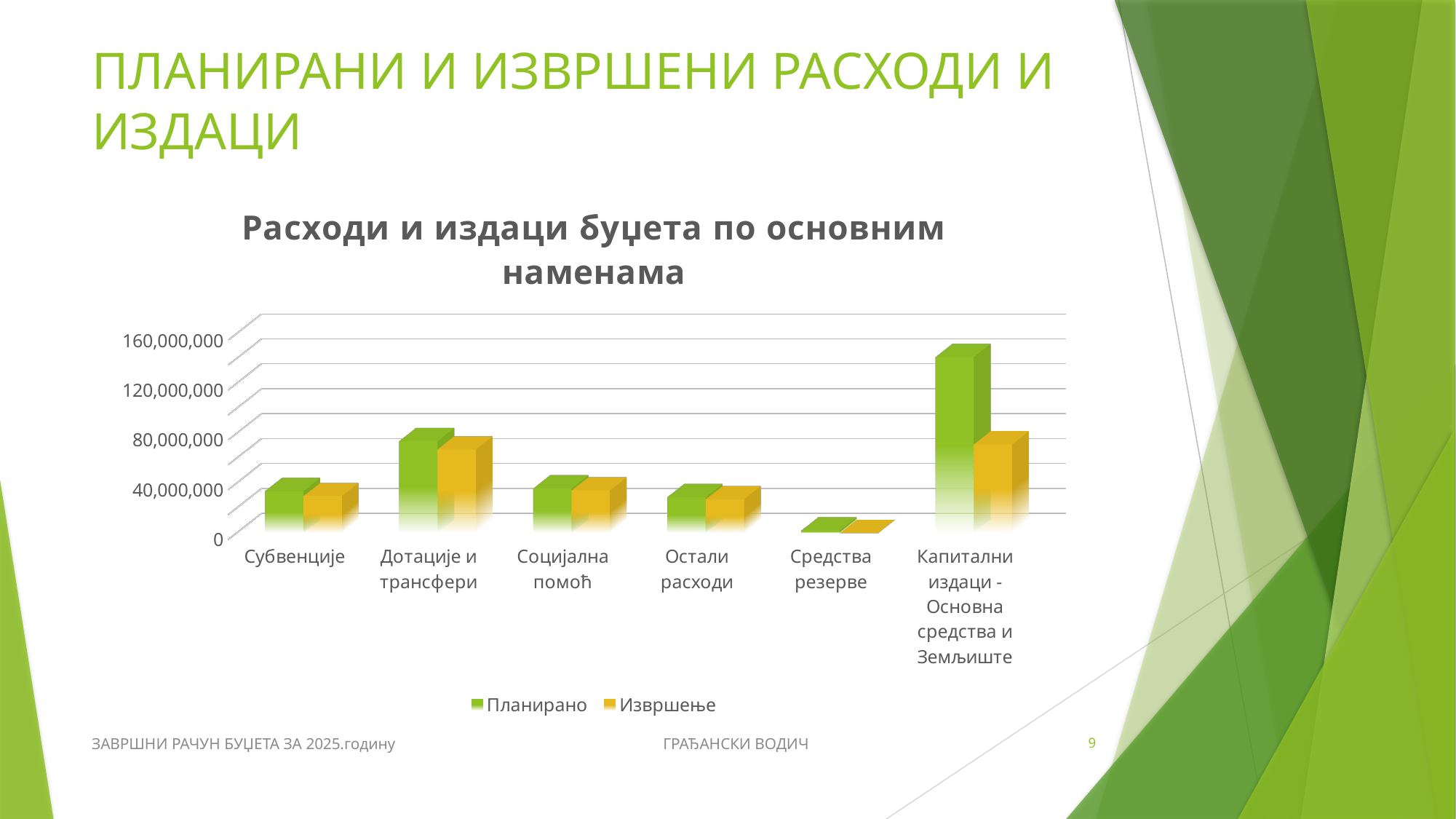
Is the Планирано value for Дотације и трансфери greater or less than 40,000,000? greater How many series does the legend list? 2 Is the Планирано value for Средства резерве greater or less than 40,000,000? less Which category has the lowest Извршење value? Средства резерве What is the title of the chart? Расходи и издаци буџета по основним наменама Which colour represents the Извршење series? Yellow Is the Извршење value for Капитални издаци - Основна средства и Земљиште greater or less than 120,000,000? less For Капитални издаци - Основна средства и Земљиште, which is larger: Планирано or Извршење? Планирано How many categories are shown on the x axis? 6 Which category has the highest Планирано value? Капитални издаци - Основна средства и Земљиште What kind of chart is shown on the slide? Bar chart